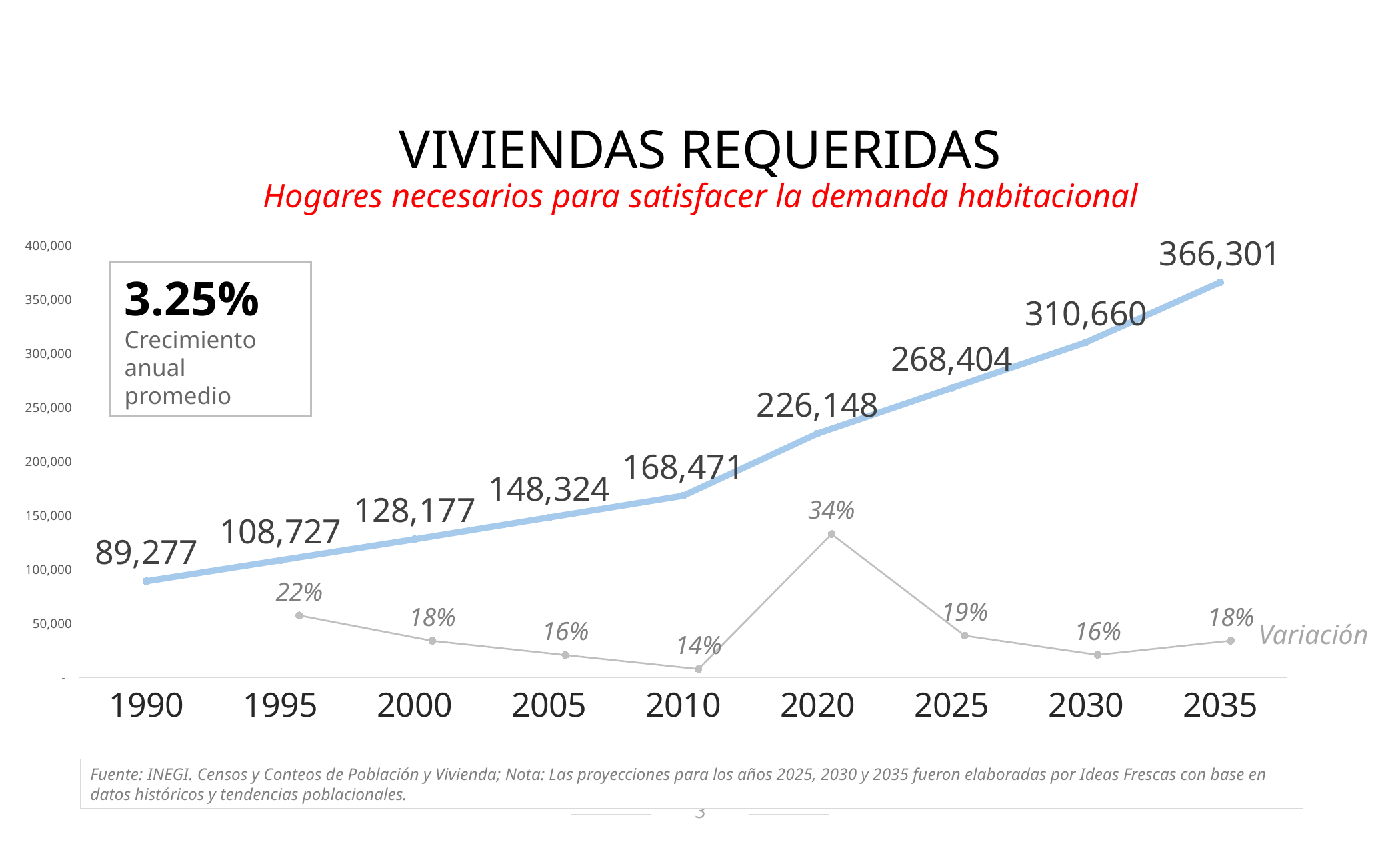
Which year has the highest value of viviendas requeridas? 2035 Which is larger, the viviendas requeridas value for 2020 or for 2025? 2025 What is the Variación percentage shown for 2020? 34% What kind of chart is shown on the slide? Line chart Which year has the lowest Variación percentage? 2010 What average annual growth rate is shown in the box on the chart? 3.25% What is the Variación percentage shown for 2010? 14% What is the value of viviendas requeridas for 1990? 89,277 How many years are shown on the x axis? 9 What is the value of viviendas requeridas for 2010? 168,471 Does the viviendas requeridas line rise or fall from 1990 to 2035? Rises What is the difference between the viviendas requeridas values for 2035 and 2030? 55,641